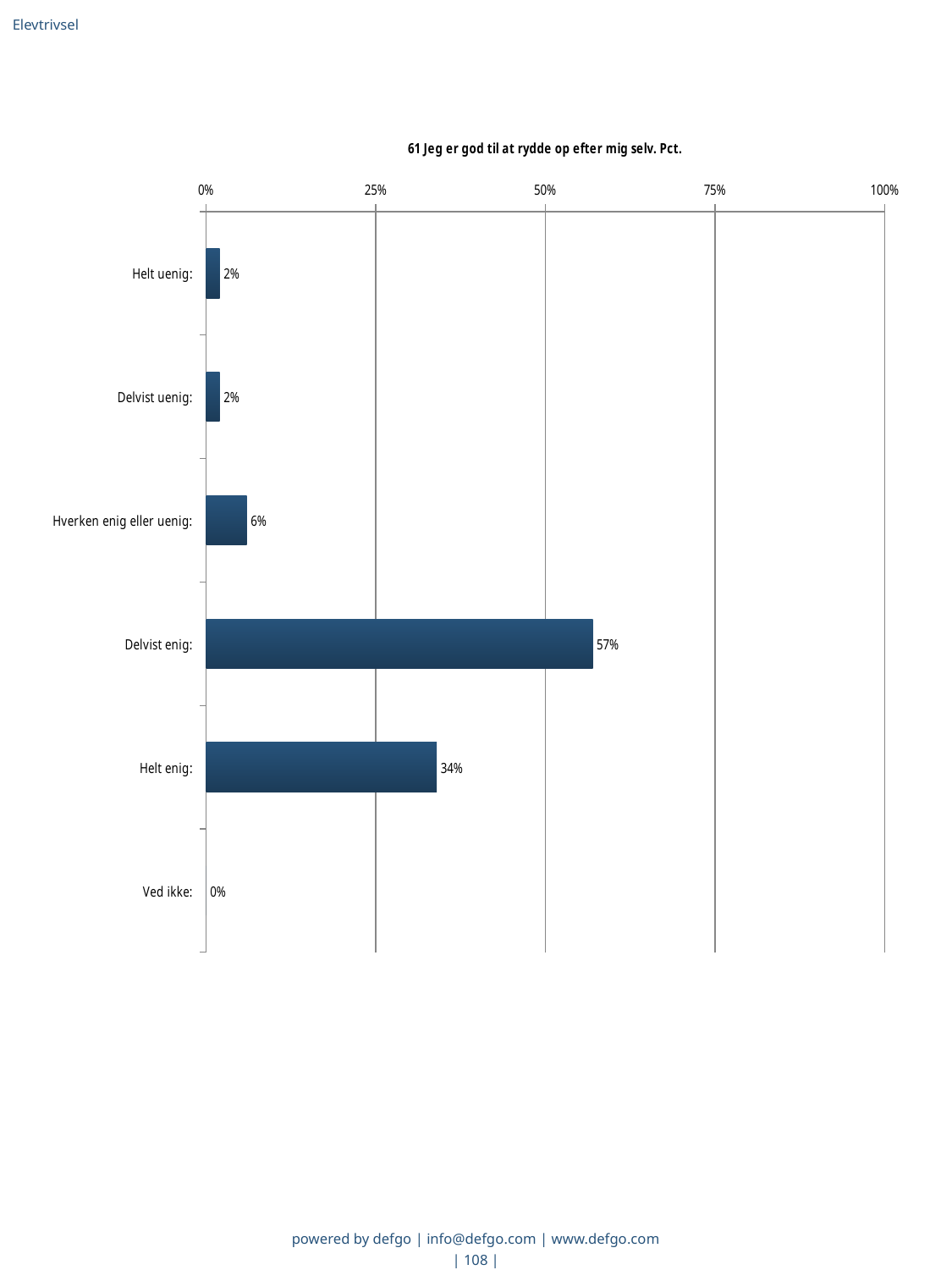
What is the value for "Hverken enig eller uenig"? 6% Which category has the highest value? Delvist enig Which category has the lowest value? Ved ikke Is the value for "Delvist enig" greater or less than 50%? greater What is the value for "Helt enig"? 34% What is the title of the chart? 61 Jeg er god til at rydde op efter mig selv. Pct. What is the difference between the values for "Delvist enig" and "Helt enig"? 23% How many categories are shown on the chart? 6 What kind of chart is shown on the slide? Bar chart What is the value for "Delvist enig"? 57% Which is larger, the value for "Helt enig" or the value for "Hverken enig eller uenig"? Helt enig What is the value for "Ved ikke"? 0%